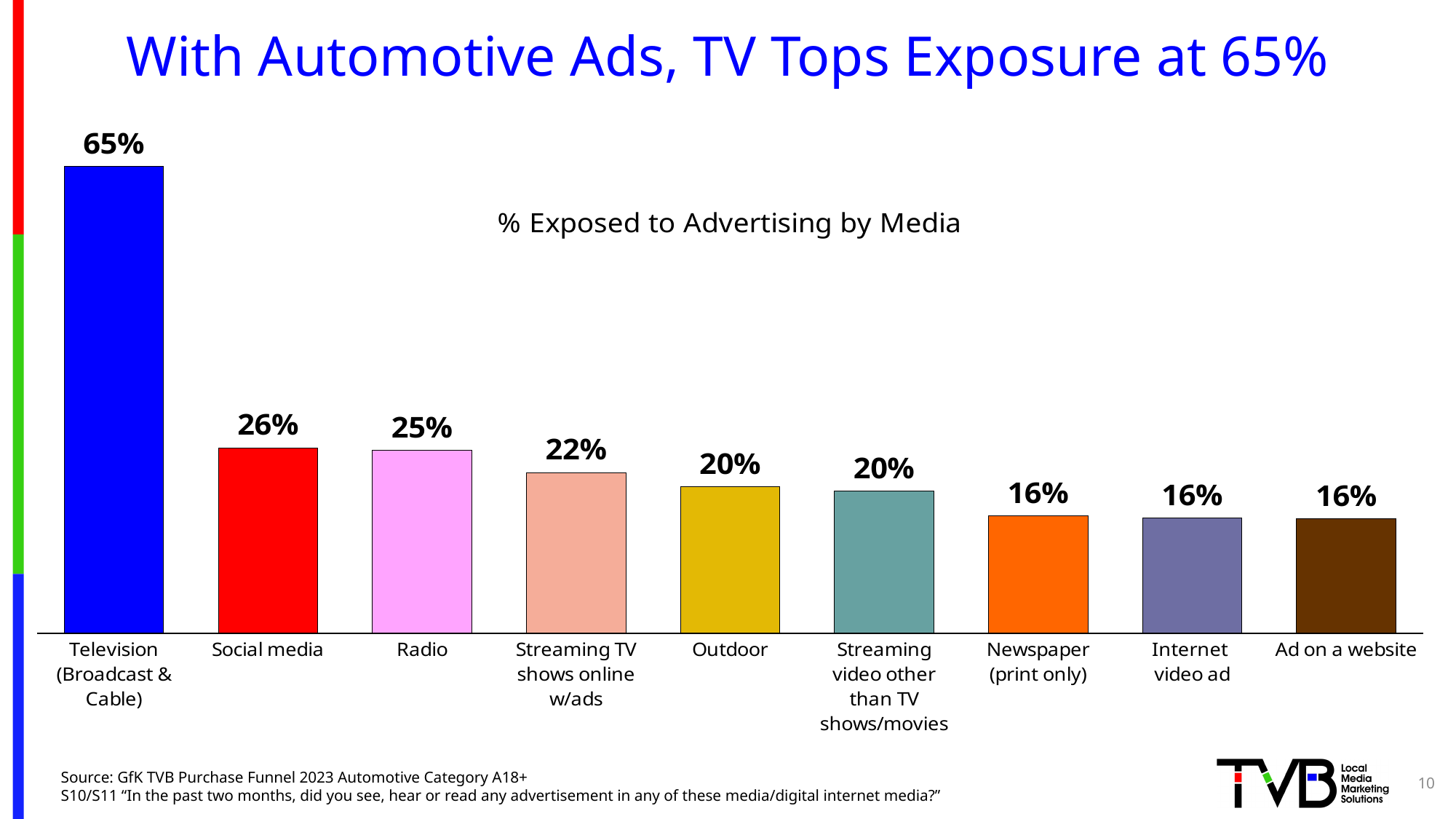
Which category has the highest value? Television (Broadcast & Cable) What is the value for Streaming TV shows online w/ads? 22% Which is larger, the value for Social media or the value for Outdoor? Social media What kind of chart is shown on the slide? Bar chart Do the values rise or fall from left to right along the x axis? Fall What is the value for Television (Broadcast & Cable)? 65% What is the difference between the values for Television (Broadcast & Cable) and Social media? 39% What is the value for Social media? 26% What is the difference between the values for Radio and Outdoor? 5% How many categories are shown in the chart? 9 What is the title of the chart? % Exposed to Advertising by Media What is the value for Newspaper (print only)? 16%